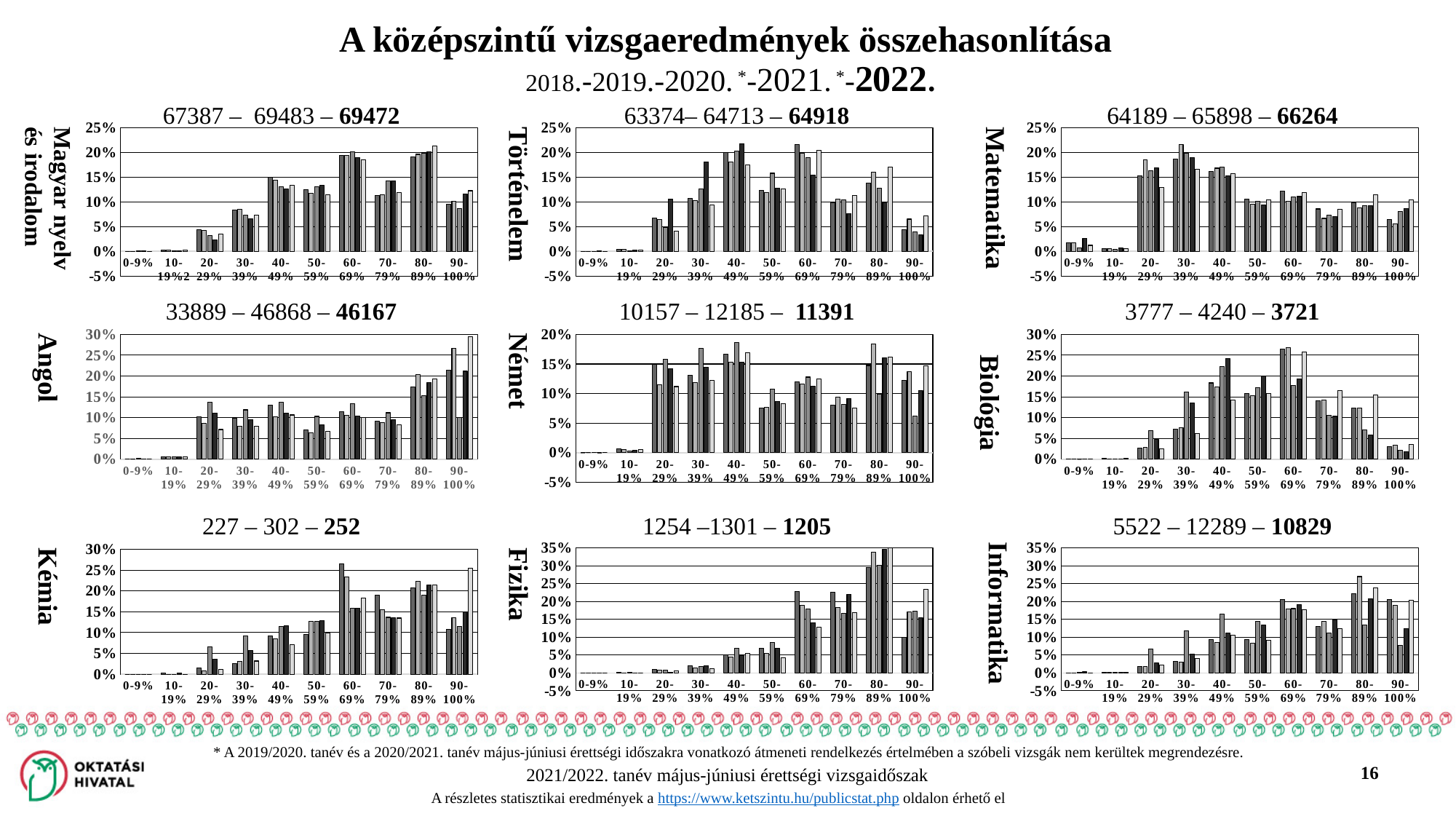
In the Fizika chart, do the values generally rise or fall from the 0-9% range to the 80-89% range? rise In the Informatika chart, which score range has the highest bars? 80-89% In the Fizika chart, are the values for the 80-89% range greater or less than 25%? greater In the Biológia chart, which score range has the highest bars? 60-69% In the Német chart, are the values for the 0-9% range greater or less than 5%? less What bold number is shown above the Matematika chart? 66264 In the Magyar nyelv és irodalom chart, are the values for the 60-69% range greater or less than 15%? greater In the Fizika chart, which score range has the highest bars? 80-89% What kind of chart is used for the Fizika (physics) results on the slide? bar chart How many score-range categories are shown on the x axis of the Kémia chart? 10 In the Angol chart, which score range has the lowest bars? 0-9%